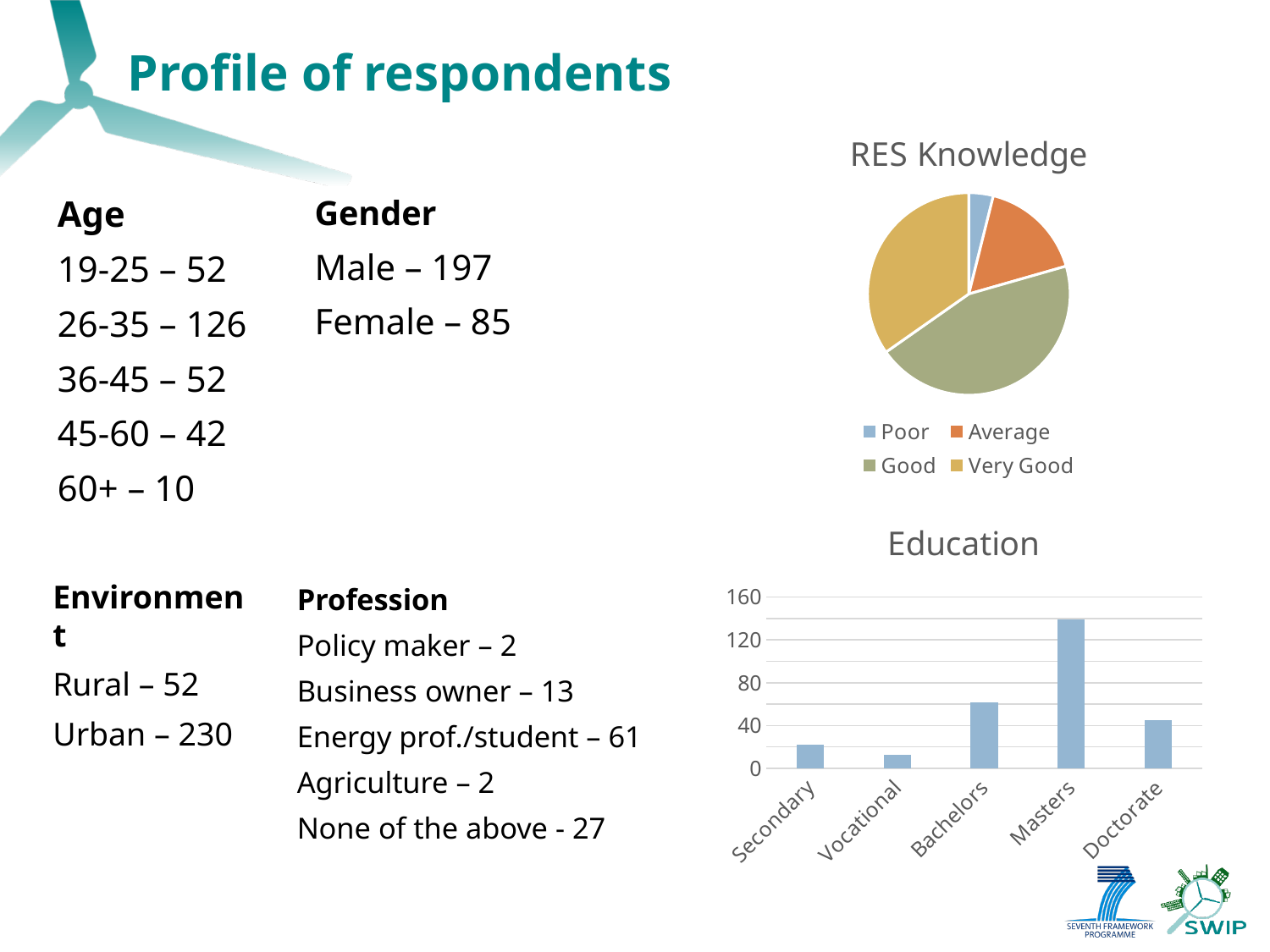
In the Education chart, is the value for Masters greater or less than 120? greater In the Education chart, which bar is taller, Doctorate or Secondary? Doctorate In the RES Knowledge chart, which category has the smallest slice? Poor What type of chart is the RES Knowledge chart? pie chart In the Education chart, how many categories are shown on the x axis? 5 In the RES Knowledge chart, which slice is larger, Very Good or Average? Very Good In the Education chart, which category has the highest bar? Masters In the Education chart, is the value for Bachelors greater or less than 40? greater In the RES Knowledge chart, how many categories does the legend list? 4 What type of chart is the Education chart? bar chart In the Education chart, which category has the lowest bar? Vocational In the RES Knowledge chart, which category has the largest slice? Good